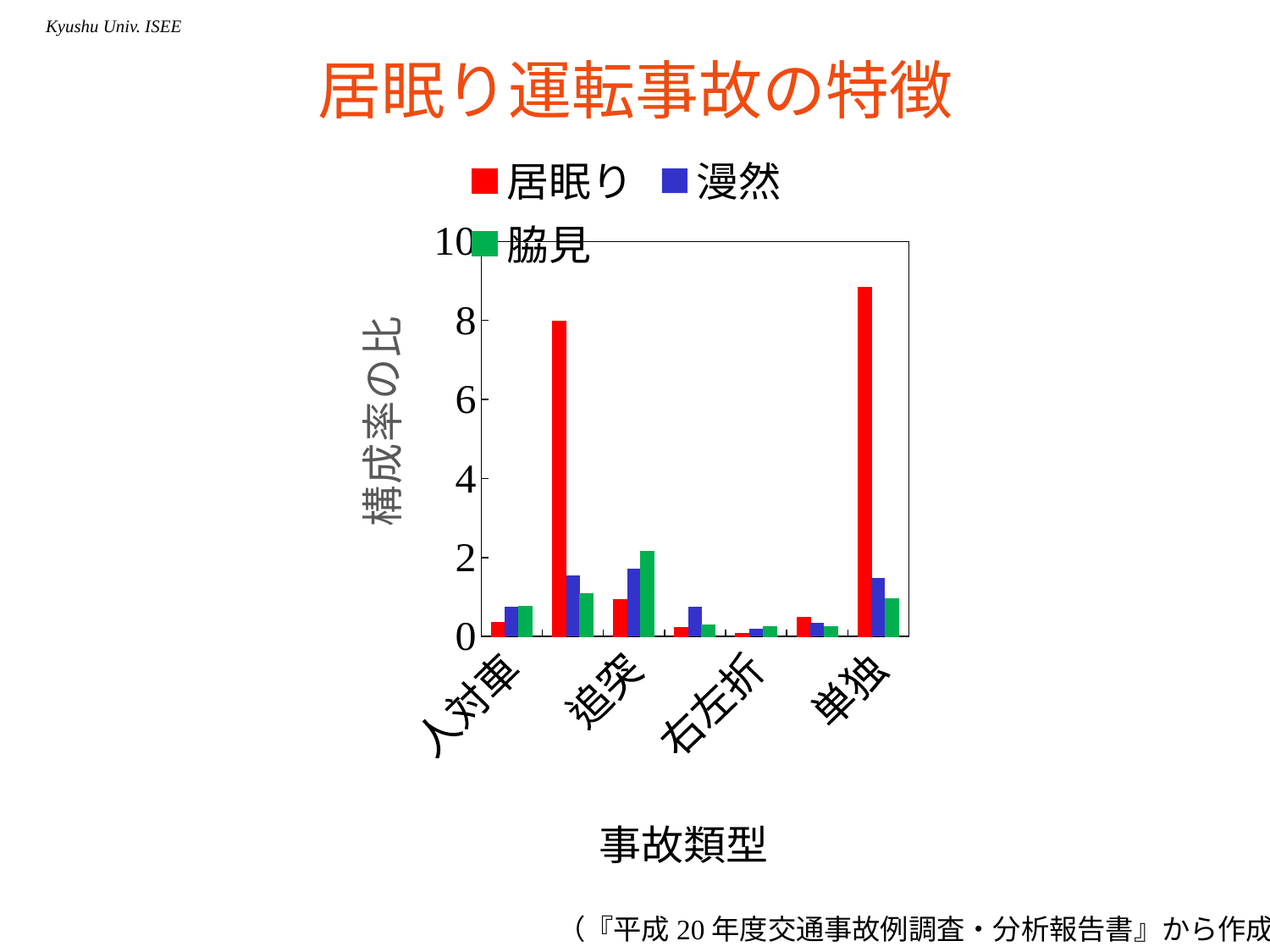
Is the value for 居眠り at 単独 greater or less than 8? greater What is the title of the y axis? 構成率の比 Which is larger at 追突, the 居眠り value or the 脇見 value? 脇見 What kind of chart is shown on the slide? bar chart At 単独, which series has the highest value? 居眠り What are the three series named in the legend? 居眠り, 漫然, 脇見 Is the value for 漫然 at 単独 greater or less than 4? less Which is larger, the 居眠り value at 単独 or the 居眠り value at 追突? 単独 How many series does the legend list? 3 Is the value for 脇見 at 追突 greater or less than 2? greater Among the labelled accident types, which has the highest 居眠り value? 単独